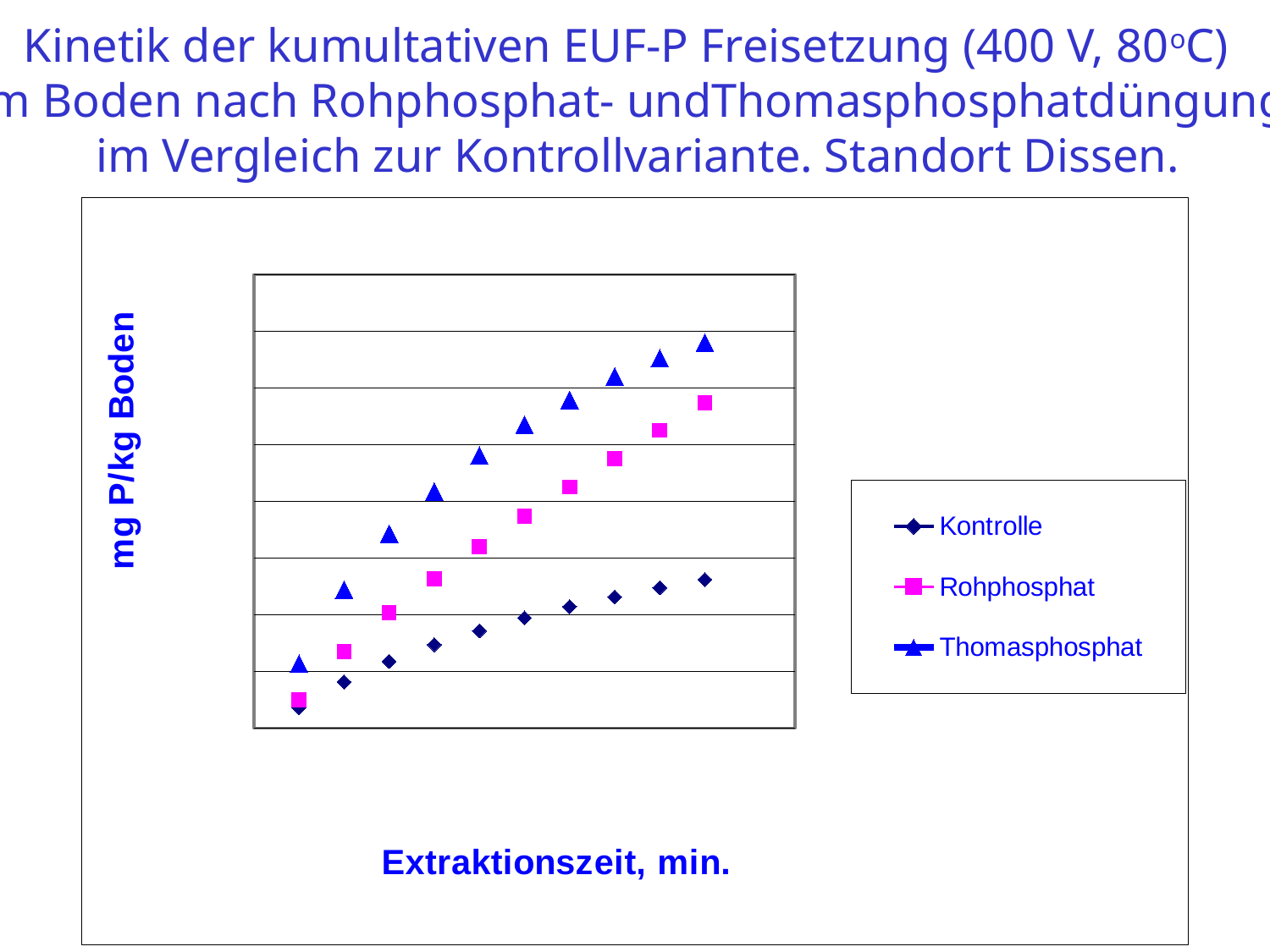
How many data points are plotted for the Thomasphosphat series? 10 Which series has the highest values at the end of the extraction time? Thomasphosphat At the last extraction time point, which is larger: the value for Thomasphosphat or the value for Rohphosphat? Thomasphosphat How many series does the legend list? 3 At the last extraction time point, which is larger: the value for Rohphosphat or the value for Kontrolle? Rohphosphat How many data points are plotted for the Kontrolle series? 10 Which series has the lowest values throughout the chart? Kontrolle What is the label of the x axis? Extraktionszeit, min. What is the label of the y axis? mg P/kg Boden Do the values for Kontrolle rise or fall as extraction time increases? rise Do the values for Thomasphosphat rise or fall along the x axis? rise What kind of chart is shown on the slide? scatter chart